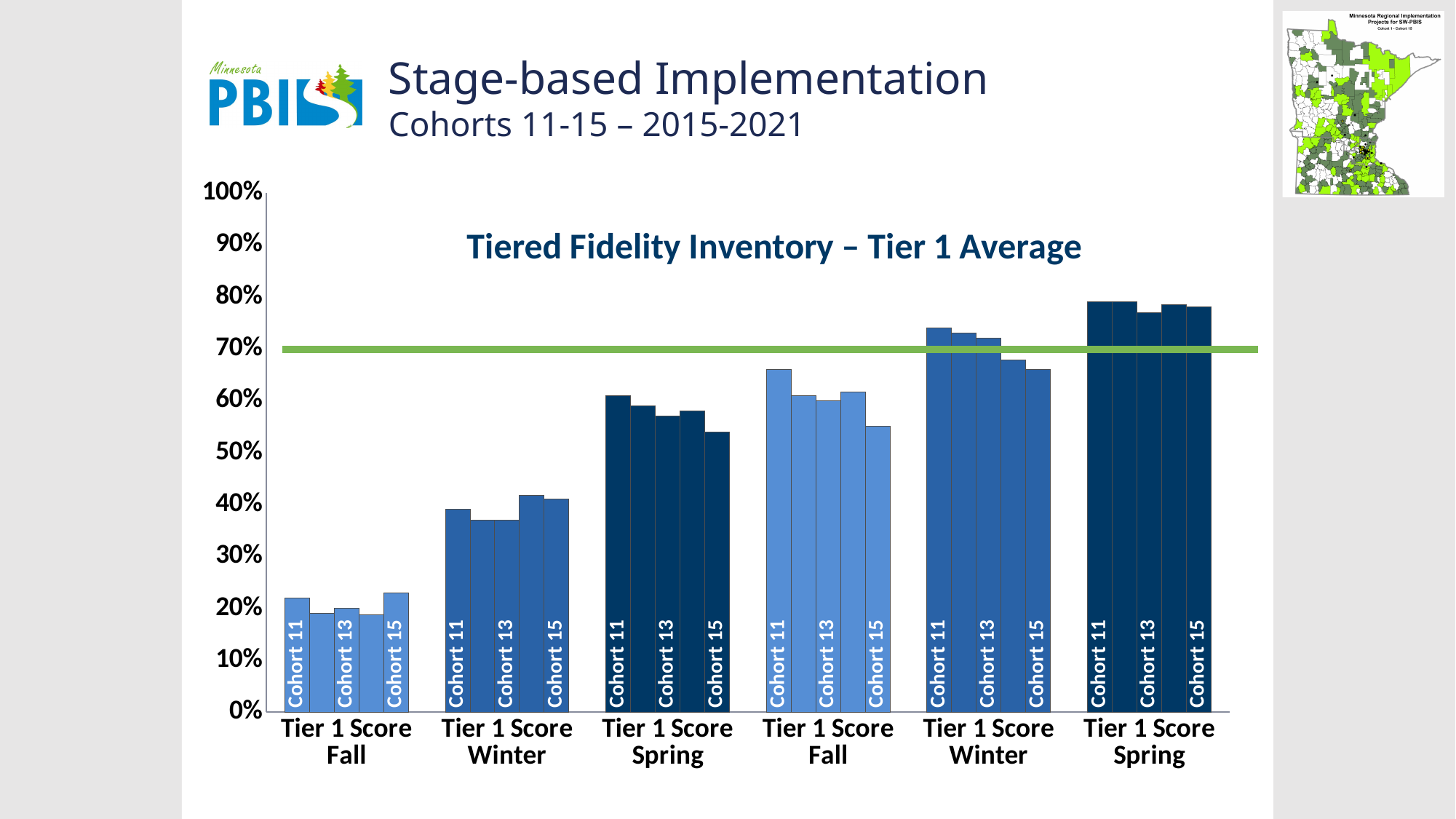
Is the value for Cohort 11 in the leftmost Tier 1 Score Fall group greater or less than 30%? less How many category groups are shown along the x axis of the chart? 6 What is the title of the chart? Tiered Fidelity Inventory – Tier 1 Average Do the bar values generally rise or fall from left to right across the chart? Rise Which is larger: the value for Cohort 11 in the leftmost Tier 1 Score Fall group or the value for Cohort 11 in the rightmost Tier 1 Score Spring group? Cohort 11 in the rightmost Tier 1 Score Spring group Is the value for Cohort 11 in the second Tier 1 Score Fall group greater or less than 70%? less Is the value for Cohort 11 in the rightmost Tier 1 Score Spring group greater or less than 70%? greater At what value does the green horizontal line cross the y axis? 70% How many bars are in each category group of the chart? 5 Which category group has the lowest bars in the chart? Tier 1 Score Fall (the leftmost group) What kind of chart is shown on the slide? Bar chart Which category group has the highest bars in the chart? Tier 1 Score Spring (the rightmost group)